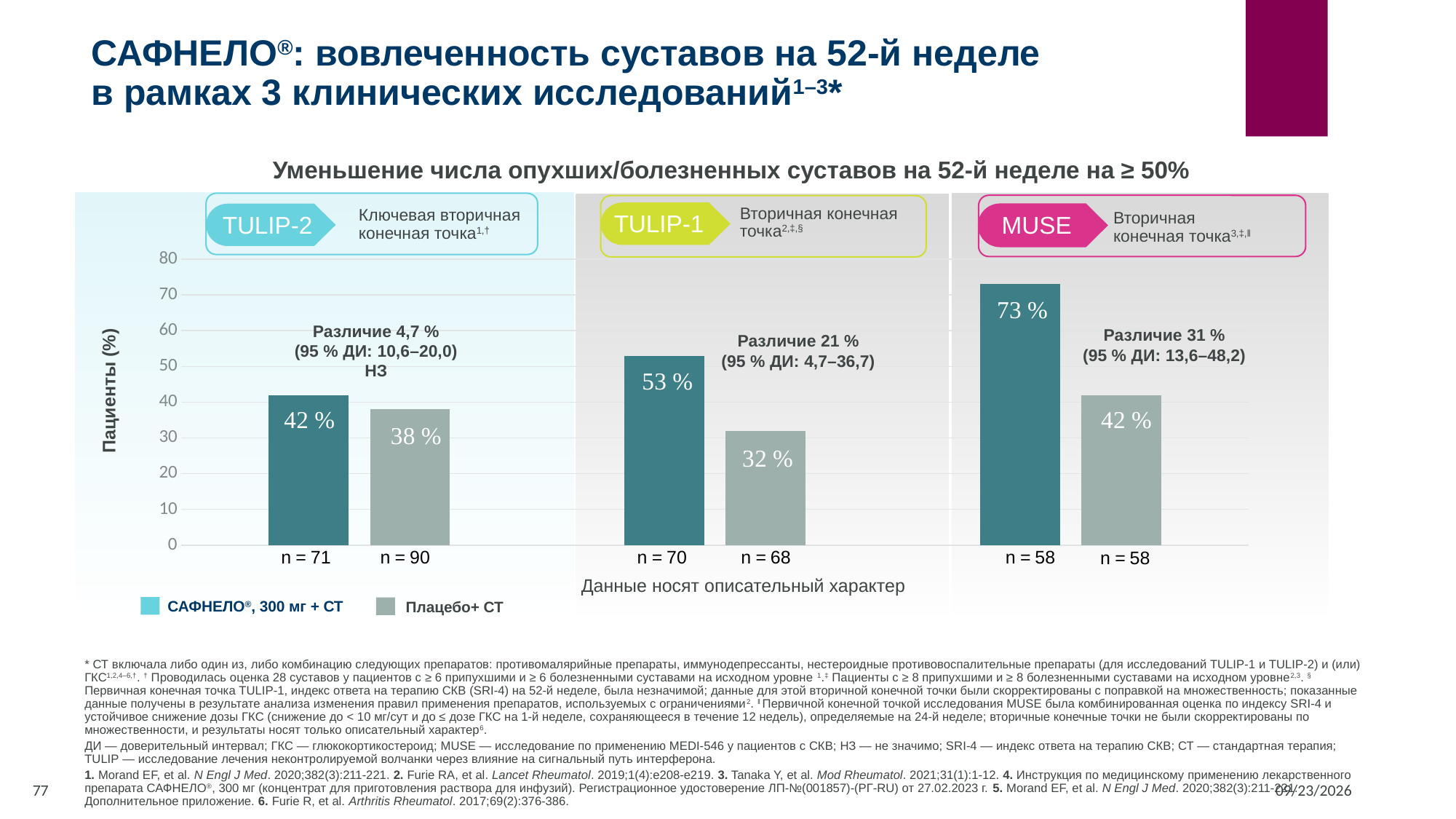
What is the difference between the САФНЕЛО and placebo values in the MUSE study? 31 % What type of chart is shown on the slide? Bar chart What is the label of the vertical axis of the chart? Пациенты (%) How many series does the chart legend list? 2 In the TULIP-2 study, which is larger: the САФНЕЛО, 300 мг + СТ value or the Плацебо + СТ value? САФНЕЛО, 300 мг + СТ Which study shows the highest value for САФНЕЛО, 300 мг + СТ? MUSE How many studies (groups of bars) are shown in the chart? 3 Which study shows the lowest value for Плацебо + СТ? TULIP-1 What is the difference between the САФНЕЛО and placebo values in the TULIP-1 study? 21 % What is the value for САФНЕЛО, 300 мг + СТ in the MUSE study? 73 % What is the value for Плацебо + СТ in the TULIP-1 study? 32 % What is the value for САФНЕЛО, 300 мг + СТ in the TULIP-2 study? 42 %